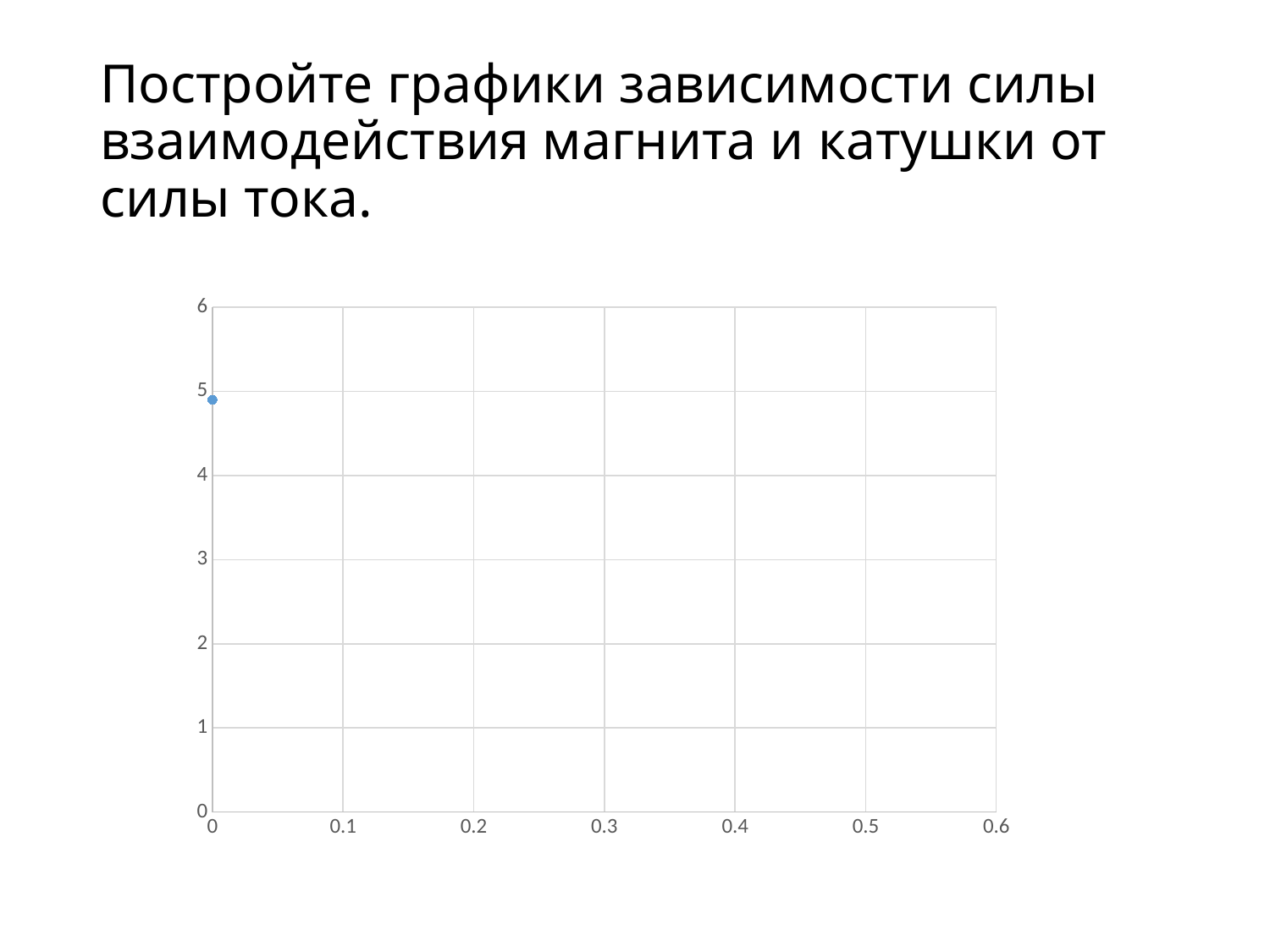
What is the highest tick value shown on the y axis? 6 Is the y-value of the plotted point greater or less than 3? greater Is the y-value of the plotted point greater or less than 6? less What is the highest tick value shown on the x axis? 0.6 How many data points are plotted on the chart? 1 What kind of chart is shown on the slide? scatter chart Is the y-value of the plotted point greater or less than 4? greater What is the x-value of the plotted point? 0